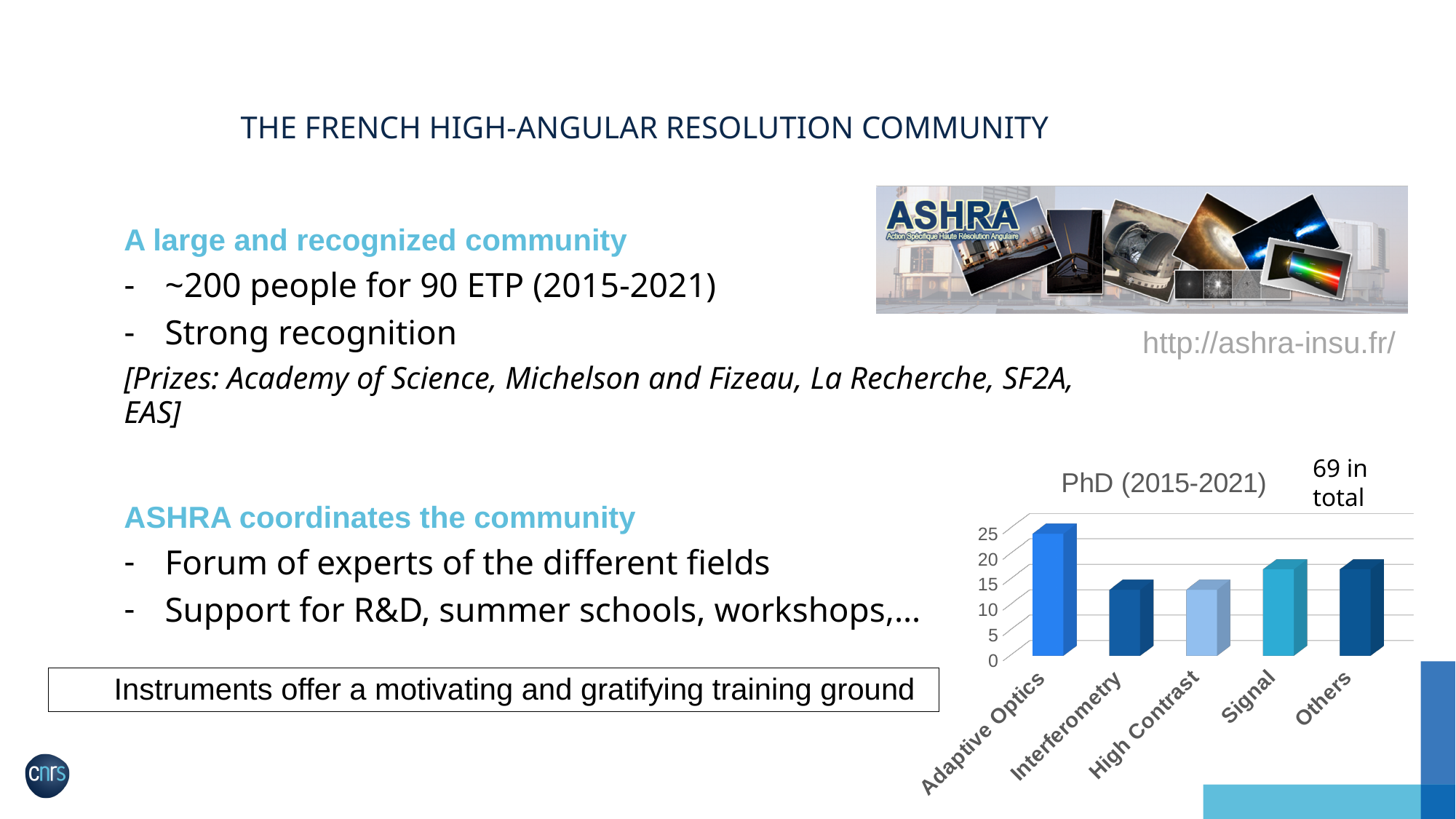
What total number of PhDs is stated next to the chart? 69 in total Is the value for Adaptive Optics greater or less than 20? greater Which is larger in the PhD (2015-2021) chart, Others or High Contrast? Others How many categories are shown on the x axis of the PhD (2015-2021) chart? 5 Which is larger in the PhD (2015-2021) chart, Adaptive Optics or Signal? Adaptive Optics What kind of chart is shown on the slide? bar chart Is the value for Interferometry greater or less than 10? greater What is the title of the chart on the slide? PhD (2015-2021) Is the value for Signal greater or less than 15? greater Which category has the highest value in the PhD (2015-2021) chart? Adaptive Optics